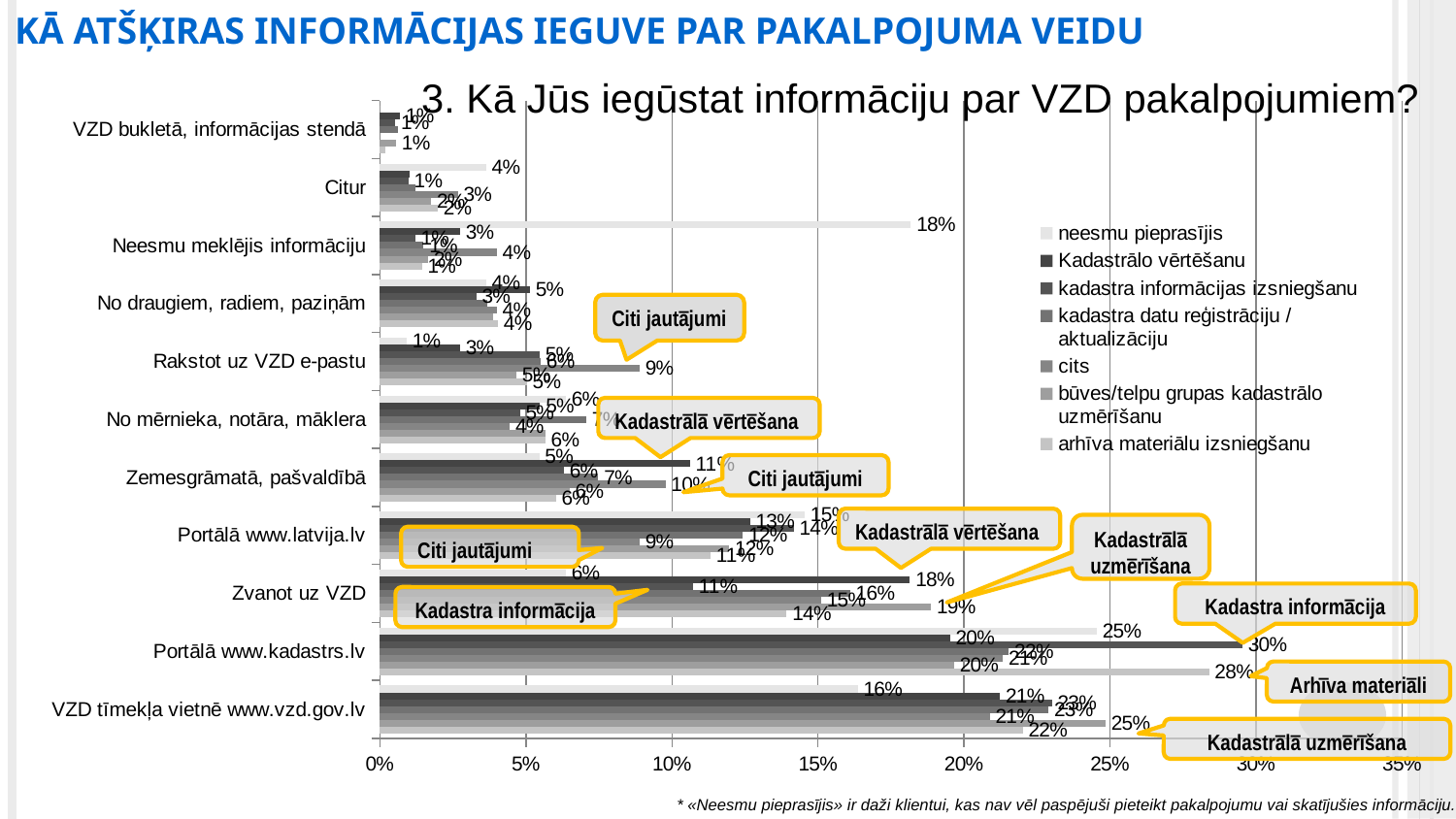
Which category has the highest value in the 'neesmu pieprasījis' series? Portālā www.kadastrs.lv How many series does the chart legend list? 7 What is the title of the chart? 3. Kā Jūs iegūstat informāciju par VZD pakalpojumiem? For 'Zvanot uz VZD', which is larger: the 'Kadastrālo vērtēšanu' value or the 'neesmu pieprasījis' value? Kadastrālo vērtēšanu How many categories are shown on the vertical axis of the chart? 11 What is the difference between the 'Kadastrālo vērtēšanu' value and the 'neesmu pieprasījis' value for 'Portālā www.kadastrs.lv'? 5 percentage points What is the value of the 'neesmu pieprasījis' series for 'Neesmu meklējis informāciju'? 18% What is the value of the 'arhīva materiālu izsniegšanu' series for 'Portālā www.kadastrs.lv'? 28% What is the value of the 'neesmu pieprasījis' series for 'Portālā www.kadastrs.lv'? 25% What type of chart is shown on the slide? Bar chart What is the value of the 'Kadastrālo vērtēšanu' series for 'Portālā www.kadastrs.lv'? 20% What is the value of the 'neesmu pieprasījis' series for 'VZD tīmekļa vietnē www.vzd.gov.lv'? 16%